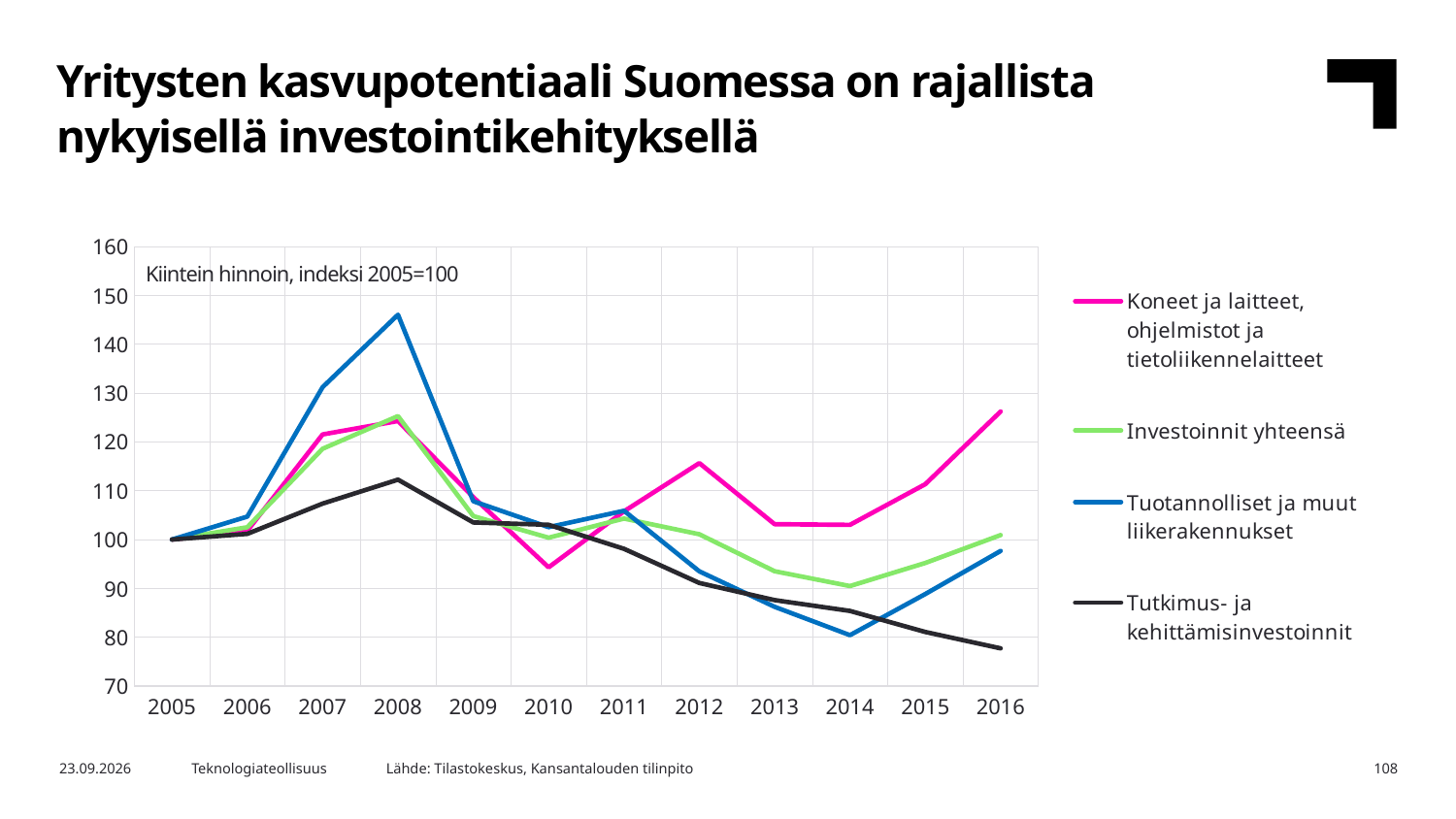
What is the index value of Investoinnit yhteensä in 2005? 100 Is the value for Koneet ja laitteet, ohjelmistot ja tietoliikennelaitteet in 2010 greater or less than 100? less Does Tutkimus- ja kehittämisinvestoinnit rise or fall from 2008 to 2016? fall Which series has the lowest value in 2016? Tutkimus- ja kehittämisinvestoinnit Is the value for Tuotannolliset ja muut liikerakennukset in 2008 greater or less than 140? greater How many series does the legend list? 4 In 2012, which is larger: Koneet ja laitteet, ohjelmistot ja tietoliikennelaitteet or Investoinnit yhteensä? Koneet ja laitteet, ohjelmistot ja tietoliikennelaitteet Is the value for Tutkimus- ja kehittämisinvestoinnit in 2016 greater or less than 80? less What kind of chart is shown on the slide? line chart Which series has the highest value in 2008? Tuotannolliset ja muut liikerakennukset In which year does Tuotannolliset ja muut liikerakennukset reach its peak? 2008 How many years are shown on the x axis? 12